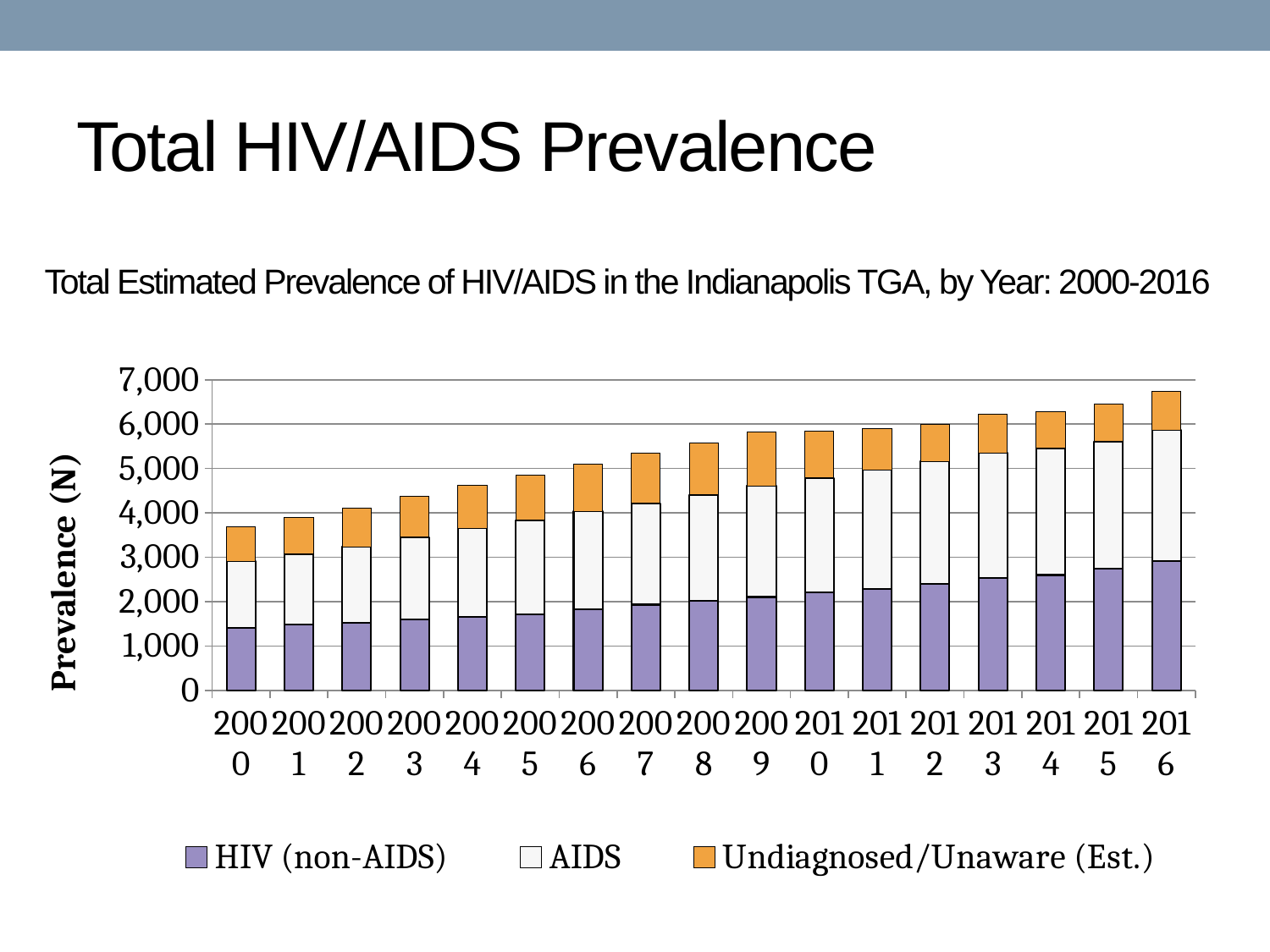
Is the total prevalence for 2016 larger or smaller than that for 2010? larger How many series does the legend list? 3 What kind of chart is shown on the slide? Stacked bar chart Is the total prevalence for 2000 greater or less than 4,000? less Does total prevalence rise or fall from 2000 to 2016? Rises Which series is shown in orange in the legend? Undiagnosed/Unaware (Est.) What is the label on the y axis? Prevalence (N) Is the total prevalence for 2008 greater or less than 5,000? greater How many years (bars) are plotted on the chart? 17 Which year has the highest total prevalence bar? 2016 Is the total prevalence for 2016 greater or less than 6,000? greater Which year has the lowest total prevalence bar? 2000